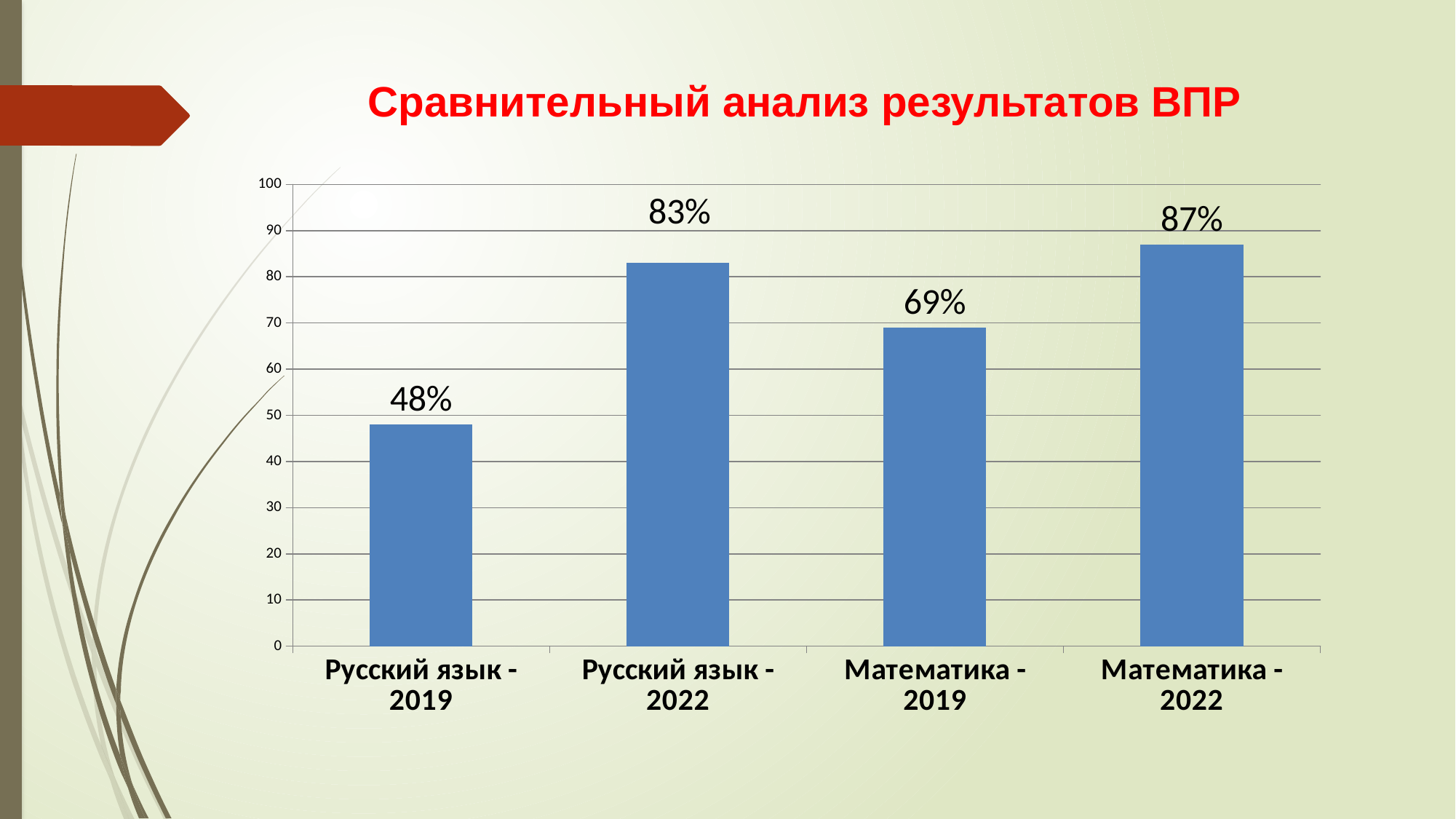
What is the value for Математика - 2022? 87% What is the difference between the values for Математика - 2022 and Математика - 2019? 18% Which category has the lowest value? Русский язык - 2019 Which category has the highest value? Математика - 2022 How many categories are shown on the chart? 4 Which is larger, the value for Русский язык - 2022 or Математика - 2019? Русский язык - 2022 What is the value for Русский язык - 2019? 48% What is the title of the slide? Сравнительный анализ результатов ВПР What is the value for Математика - 2019? 69% What is the difference between the values for Русский язык - 2022 and Русский язык - 2019? 35% What kind of chart is shown on the slide? Bar chart What is the value for Русский язык - 2022? 83%